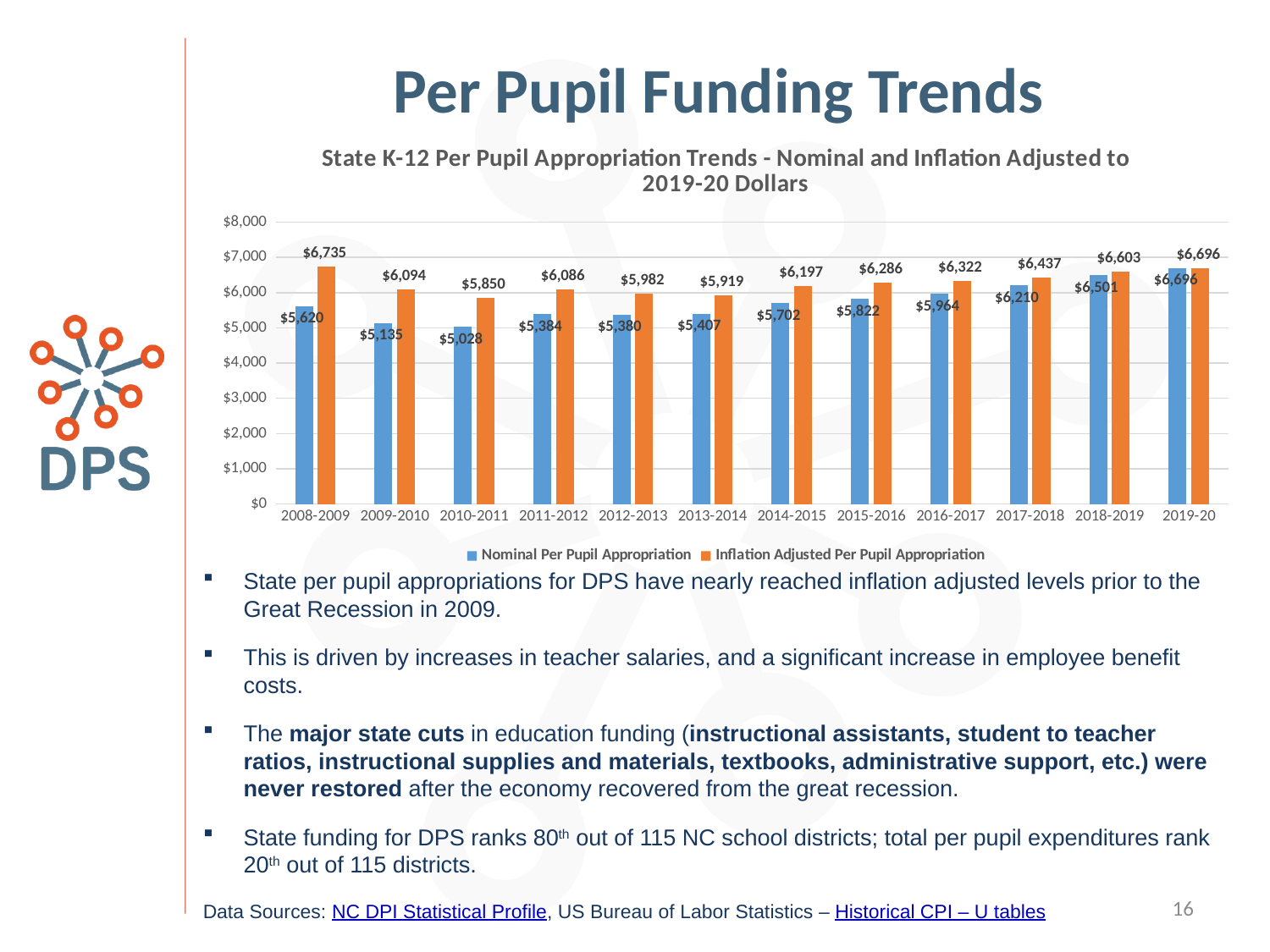
What is the Nominal Per Pupil Appropriation for 2008-2009? $5,620 How many series does the legend list? 2 What is the Inflation Adjusted Per Pupil Appropriation for 2014-2015? $6,197 What is the Nominal Per Pupil Appropriation for 2019-20? $6,696 Does the Nominal Per Pupil Appropriation rise or fall from 2013-2014 to 2019-20? rise How many school years are shown on the x axis? 12 What is the difference between the Inflation Adjusted and Nominal Per Pupil Appropriation in 2008-2009? $1,115 Which year has the lowest Nominal Per Pupil Appropriation? 2010-2011 Which year has the highest Inflation Adjusted Per Pupil Appropriation? 2008-2009 What kind of chart is shown on the slide? bar chart Is the Nominal Per Pupil Appropriation for 2010-2011 greater or less than $6,000? less Which is larger, the Nominal Per Pupil Appropriation in 2017-2018 or in 2018-2019? 2018-2019